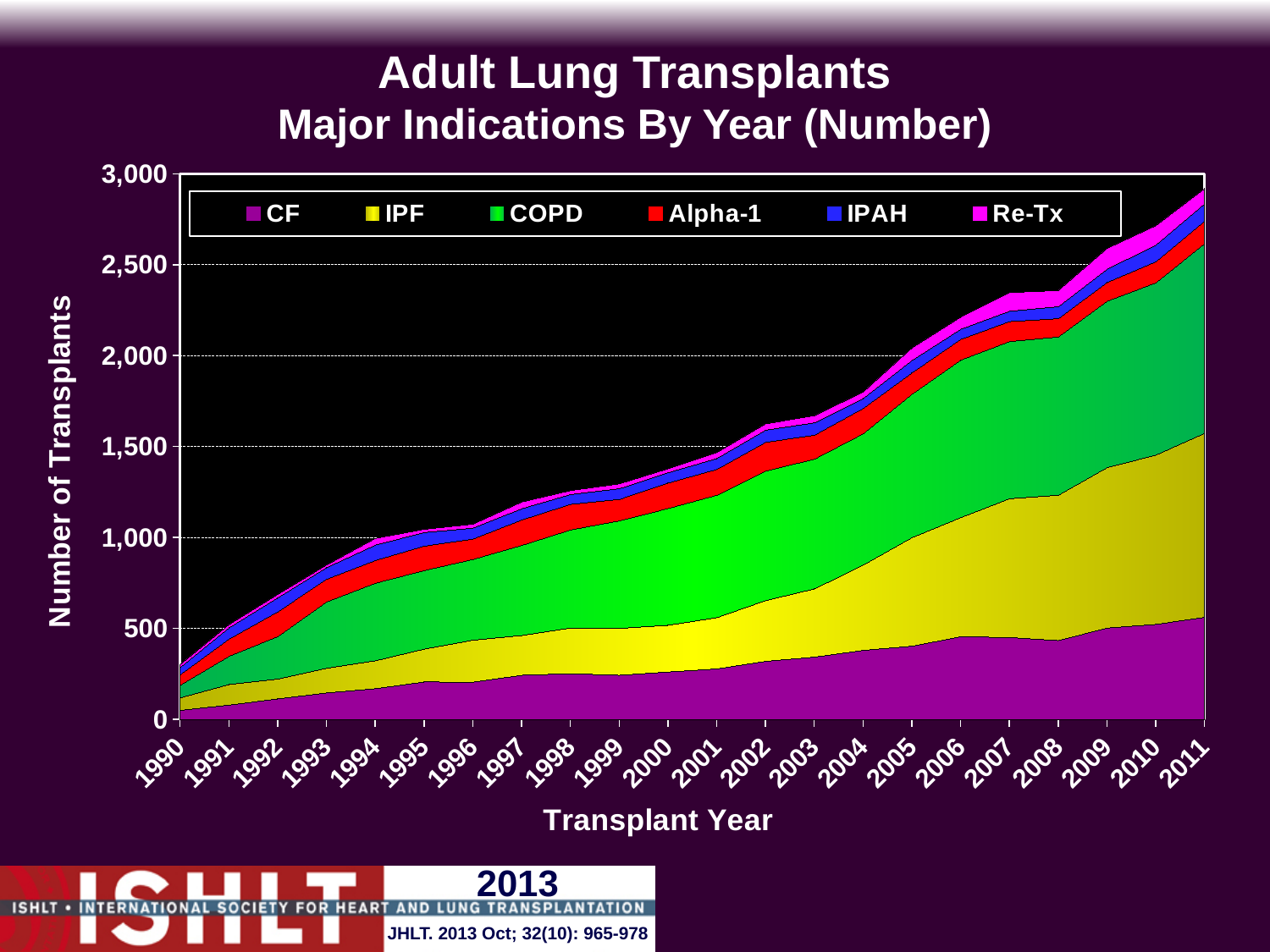
Which transplant year has the lowest total number of transplants? 1990 Is the total number of transplants in 2000 greater or less than 1,500? less How many transplant years are shown along the x axis? 22 What kind of chart is shown on the slide? Stacked area chart What is the label of the y axis? Number of Transplants Does the total number of adult lung transplants rise or fall from 1990 to 2011? Rise Is the total number of transplants in 2011 greater or less than 2,500? greater Which indication is shown in green in the chart? COPD How many series does the legend list? 6 Is the total number of transplants in 2008 greater or less than 2,000? greater Which transplant year has the highest total number of transplants? 2011